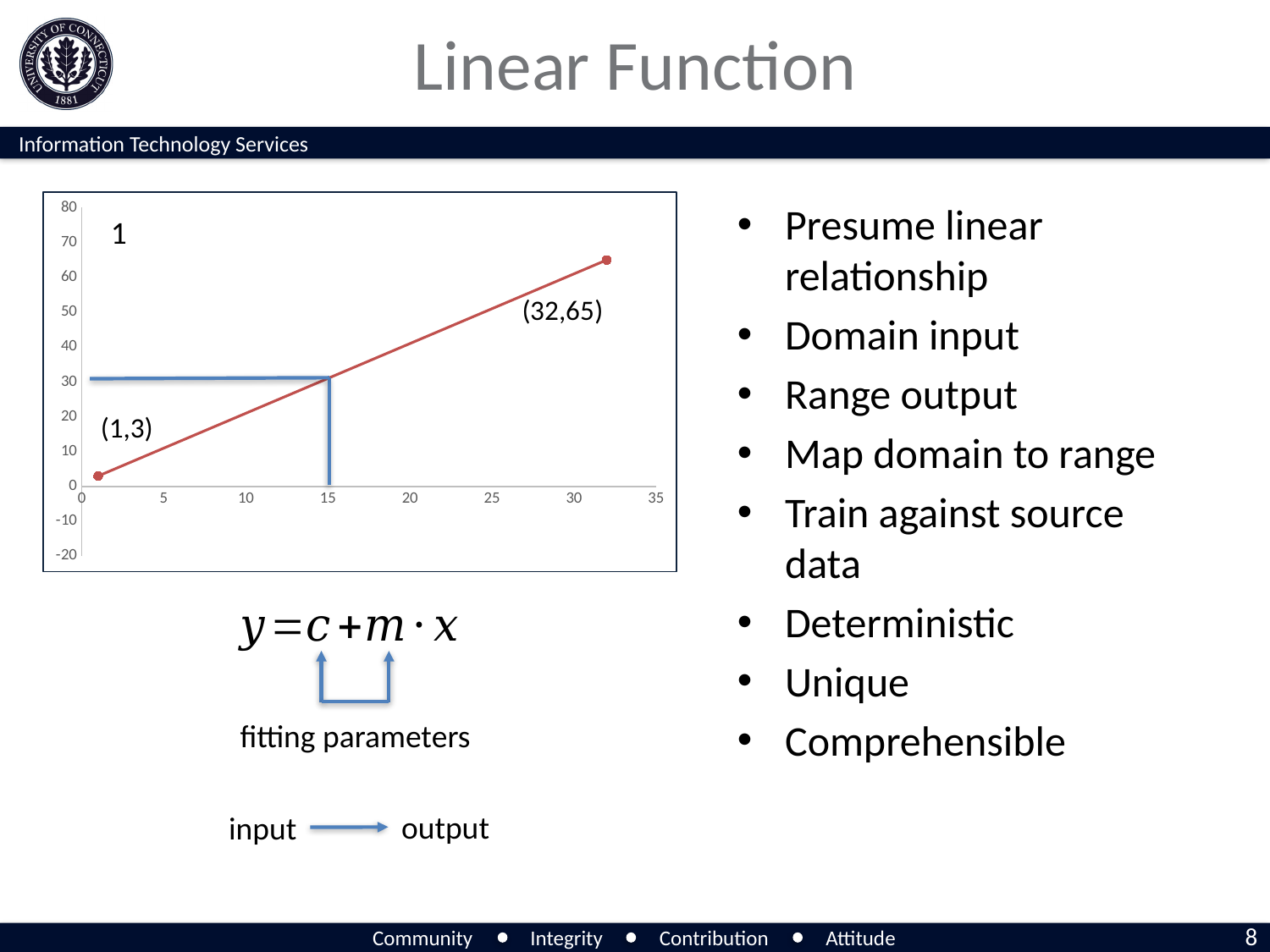
Which labelled point has the higher y value, (1,3) or (32,65)? (32,65) What is the y value of the point at x = 1? 3 What kind of chart is shown on the slide? line chart What are the coordinates of the lower-left labelled point on the chart? (1,3) What is the highest value shown on the y axis? 80 What is the difference in y value between the point (32,65) and the point (1,3)? 62 Is the y value of the line at x = 15 greater or less than 20? greater What is the y value of the point at x = 32? 65 Do the values rise or fall as x increases along the line? rise How many data points are plotted on the chart? 2 What are the coordinates of the upper-right labelled point on the chart? (32,65)